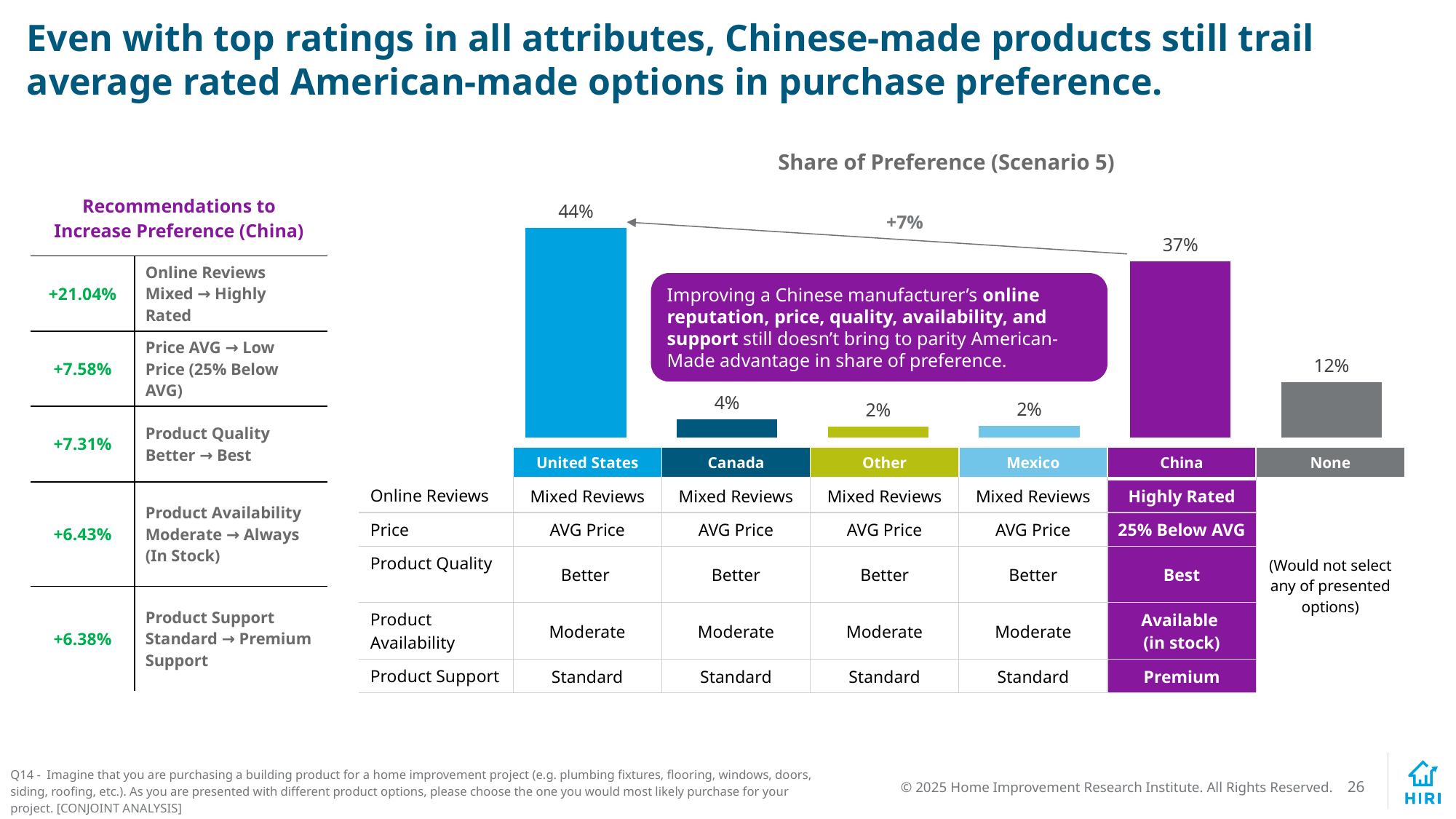
Which has a larger share of preference, None or Canada? None What is the share of preference for None? 12% What is the difference in share of preference between the United States and China? 7% What is the share of preference for the United States? 44% Which category has the highest share of preference? United States What is the title of the chart? Share of Preference (Scenario 5) What is the share of preference for Canada? 4% How many categories are shown in the Share of Preference chart? 6 What kind of chart is the Share of Preference (Scenario 5) chart? Bar chart What is the share of preference for China? 37% What is the share of preference for Mexico? 2% What colour is the bar for China? Purple